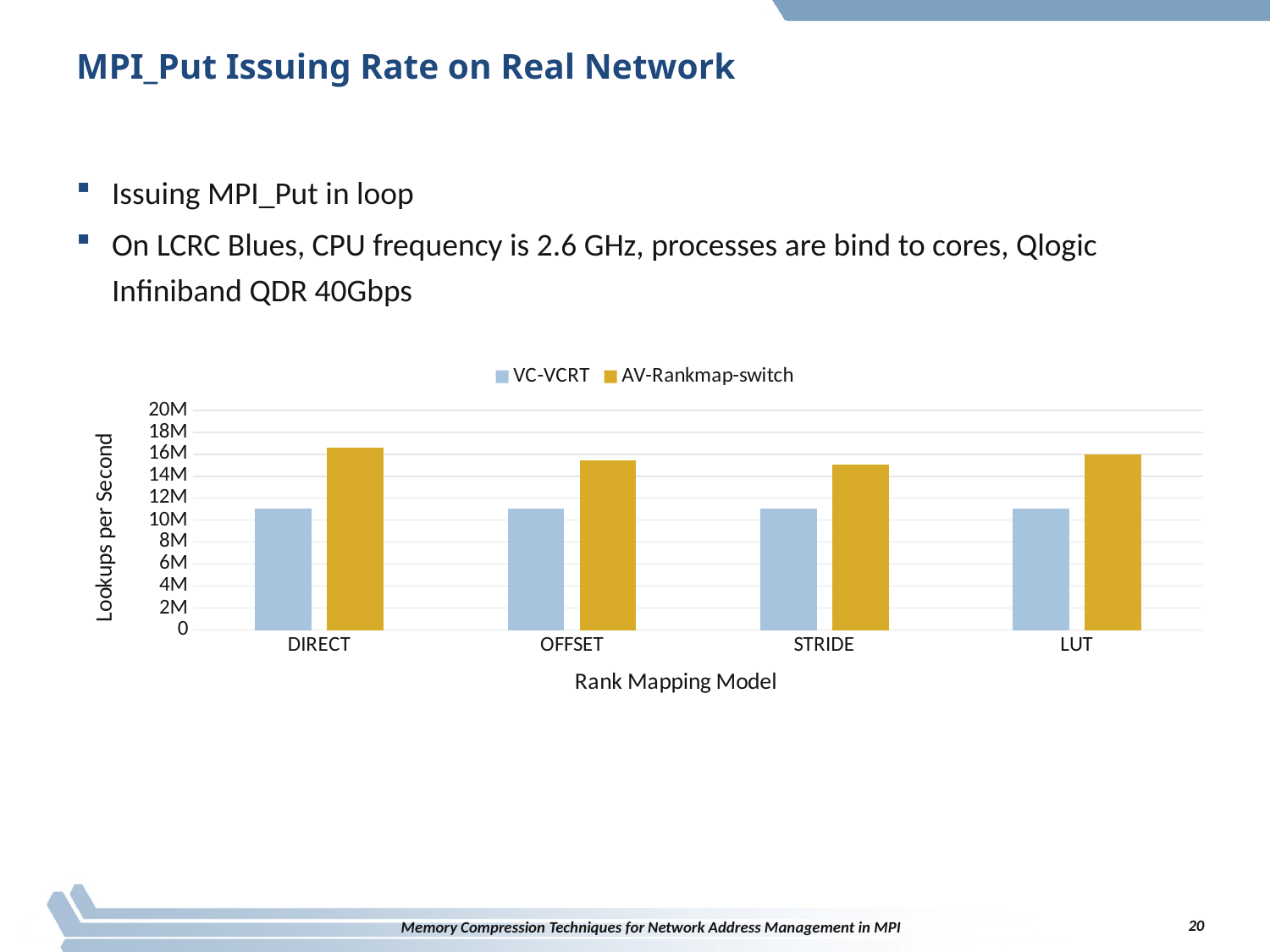
Which rank mapping model has the highest AV-Rankmap-switch value? DIRECT Is the AV-Rankmap-switch value for STRIDE greater or less than 16M? less For STRIDE, which series has the larger value, VC-VCRT or AV-Rankmap-switch? AV-Rankmap-switch What is the y-axis label of the chart? Lookups per Second Which series is shown in gold/yellow? AV-Rankmap-switch Is the VC-VCRT value for OFFSET greater or less than 12M? less What kind of chart is shown on the slide? bar chart How many rank mapping models are shown on the x axis? 4 For DIRECT, which series has the larger value, VC-VCRT or AV-Rankmap-switch? AV-Rankmap-switch Is the VC-VCRT value for LUT greater or less than 8M? greater How many series does the legend list? 2